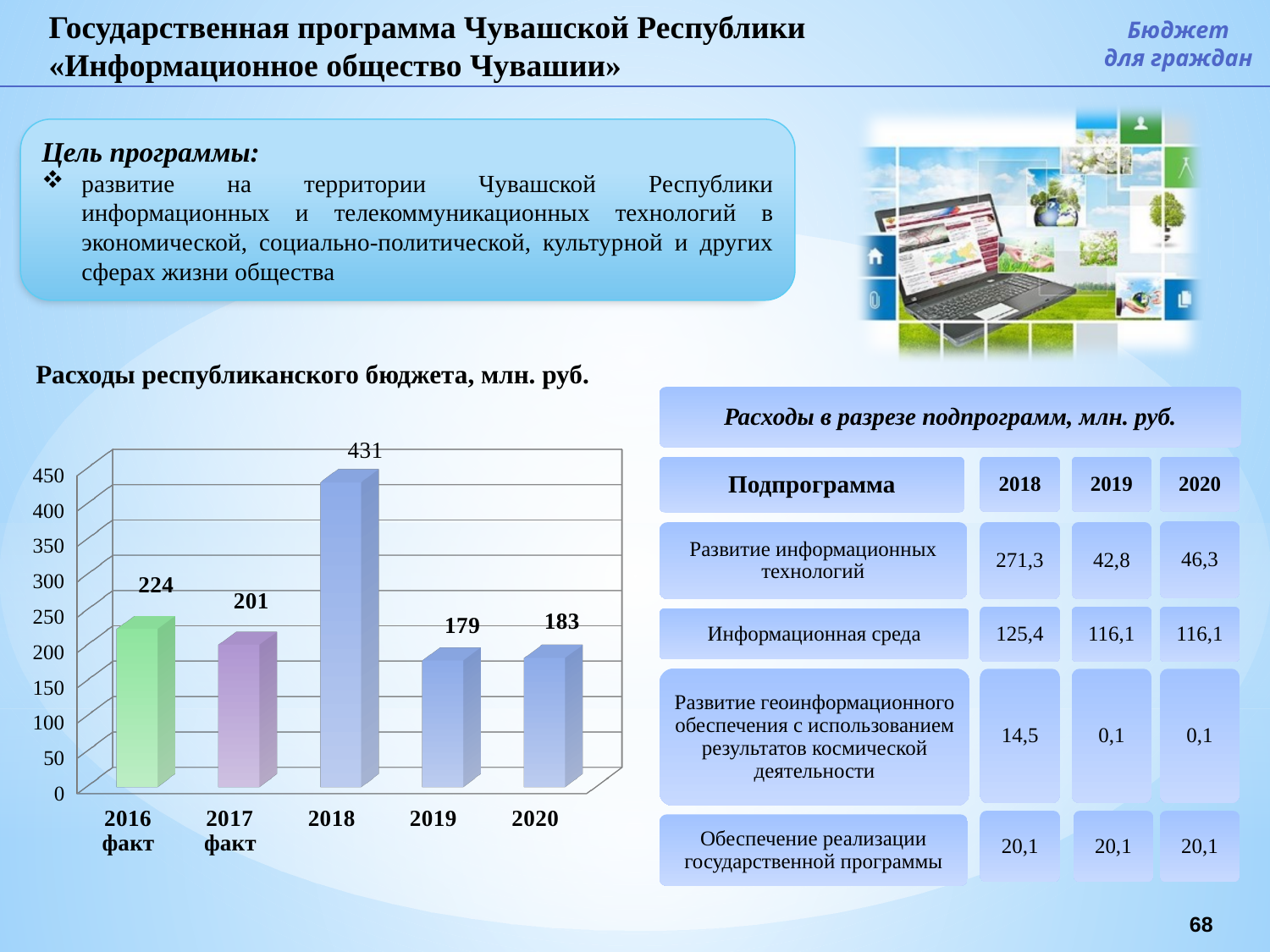
What is the value for 2019 in the chart "Расходы республиканского бюджета, млн. руб."? 179 In the chart "Расходы республиканского бюджета, млн. руб.", what is the difference between the values for 2018 and 2017 факт? 230 Which category has the lowest value in the chart "Расходы республиканского бюджета, млн. руб."? 2019 In the chart "Расходы республиканского бюджета, млн. руб.", is the value for 2018 greater or less than 400? greater What type of chart is shown under the heading "Расходы республиканского бюджета, млн. руб."? bar chart Which category has the highest value in the chart "Расходы республиканского бюджета, млн. руб."? 2018 What is the value for 2016 факт in the chart "Расходы республиканского бюджета, млн. руб."? 224 How many categories are shown on the x axis of the chart "Расходы республиканского бюджета, млн. руб."? 5 In the chart "Расходы республиканского бюджета, млн. руб.", what is the difference between the values for 2020 and 2019? 4 In the chart "Расходы республиканского бюджета, млн. руб.", does the value rise or fall from 2018 to 2019? fall In the chart "Расходы республиканского бюджета, млн. руб.", which is larger: the value for 2016 факт or the value for 2017 факт? 2016 факт What is the value for 2018 in the chart "Расходы республиканского бюджета, млн. руб."? 431